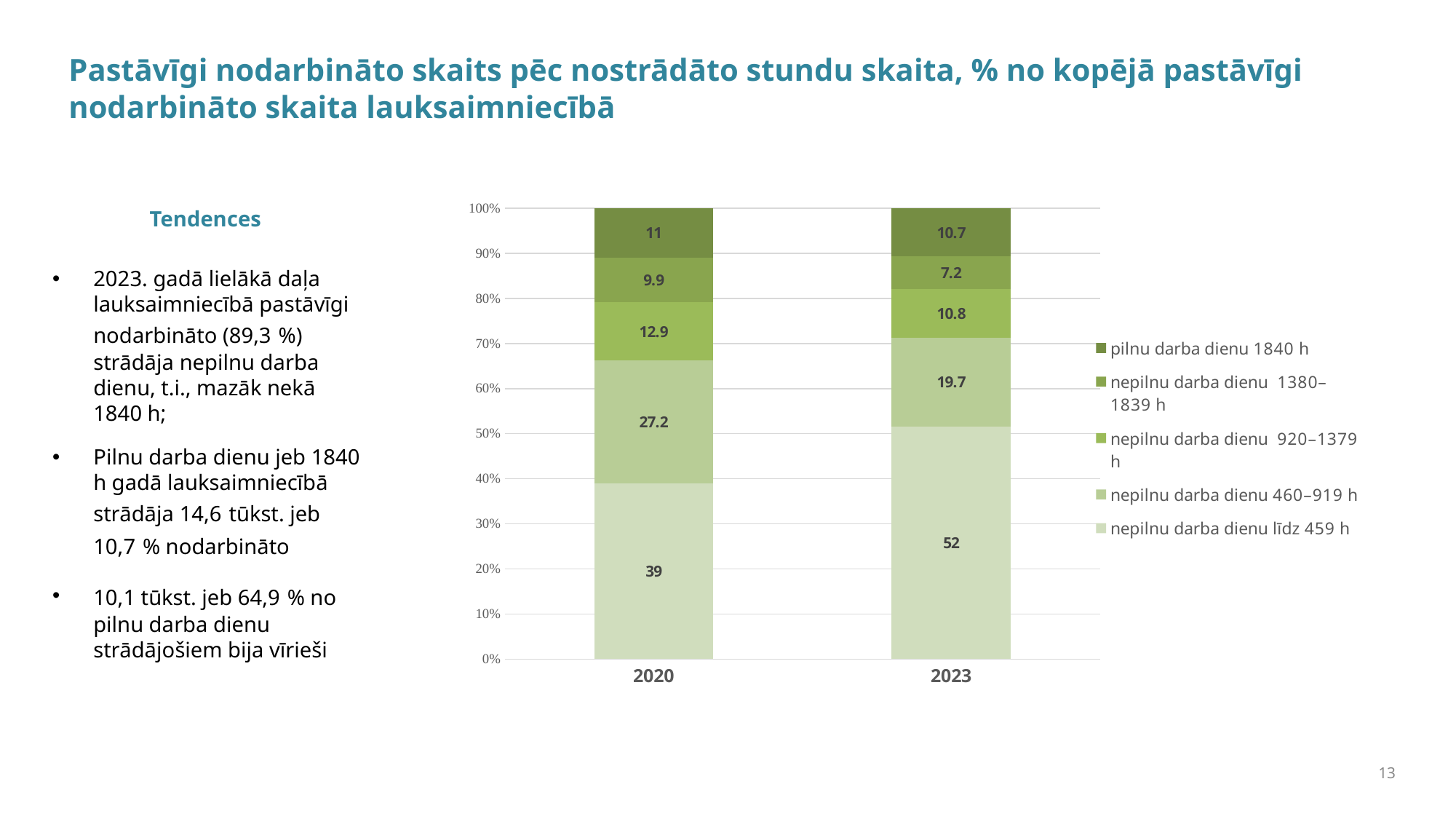
How many years are shown on the x axis of the chart? 2 Which series has the smallest value in the 2023 bar? nepilnu darba dienu 1380–1839 h What is the value for 'pilnu darba dienu 1840 h' in 2023? 10.7 What is the value for 'nepilnu darba dienu 920–1379 h' in 2020? 12.9 Which year has the larger value for 'nepilnu darba dienu 1380–1839 h', 2020 or 2023? 2020 What is the value for 'nepilnu darba dienu līdz 459 h' in 2020? 39 What is the difference between the 2020 and 2023 values for 'nepilnu darba dienu 460–919 h'? 7.5 How many series does the legend list? 5 What kind of chart is shown on the slide? Stacked bar chart By how much did the value for 'nepilnu darba dienu līdz 459 h' change from 2020 to 2023? 13 What is the value for 'nepilnu darba dienu 460–919 h' in 2023? 19.7 Which series has the largest value in the 2023 bar? nepilnu darba dienu līdz 459 h